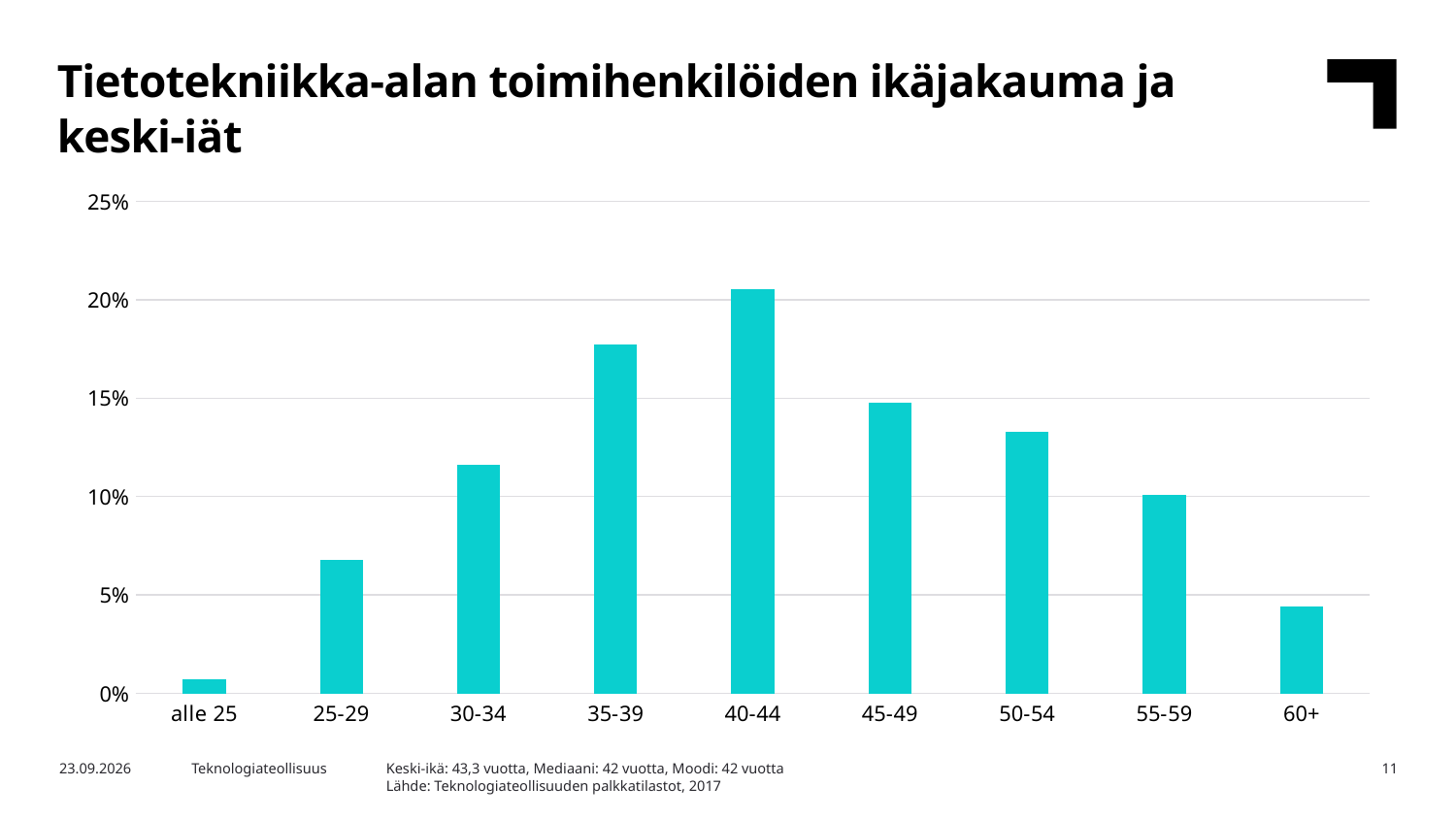
Is the value for 50-54 greater or less than 15%? less How many age groups are shown on the x axis? 9 What kind of chart is shown on the slide? bar chart Which age group has the lowest share in the chart? alle 25 Which is larger, the value for 50-54 or the value for 55-59? 50-54 Do the values rise or fall from 40-44 to 60+ along the x axis? fall Is the value for 35-39 greater or less than 15%? greater Is the value for 25-29 greater or less than 5%? greater Which age group has the highest share in the chart? 40-44 Which is larger, the value for 35-39 or the value for 45-49? 35-39